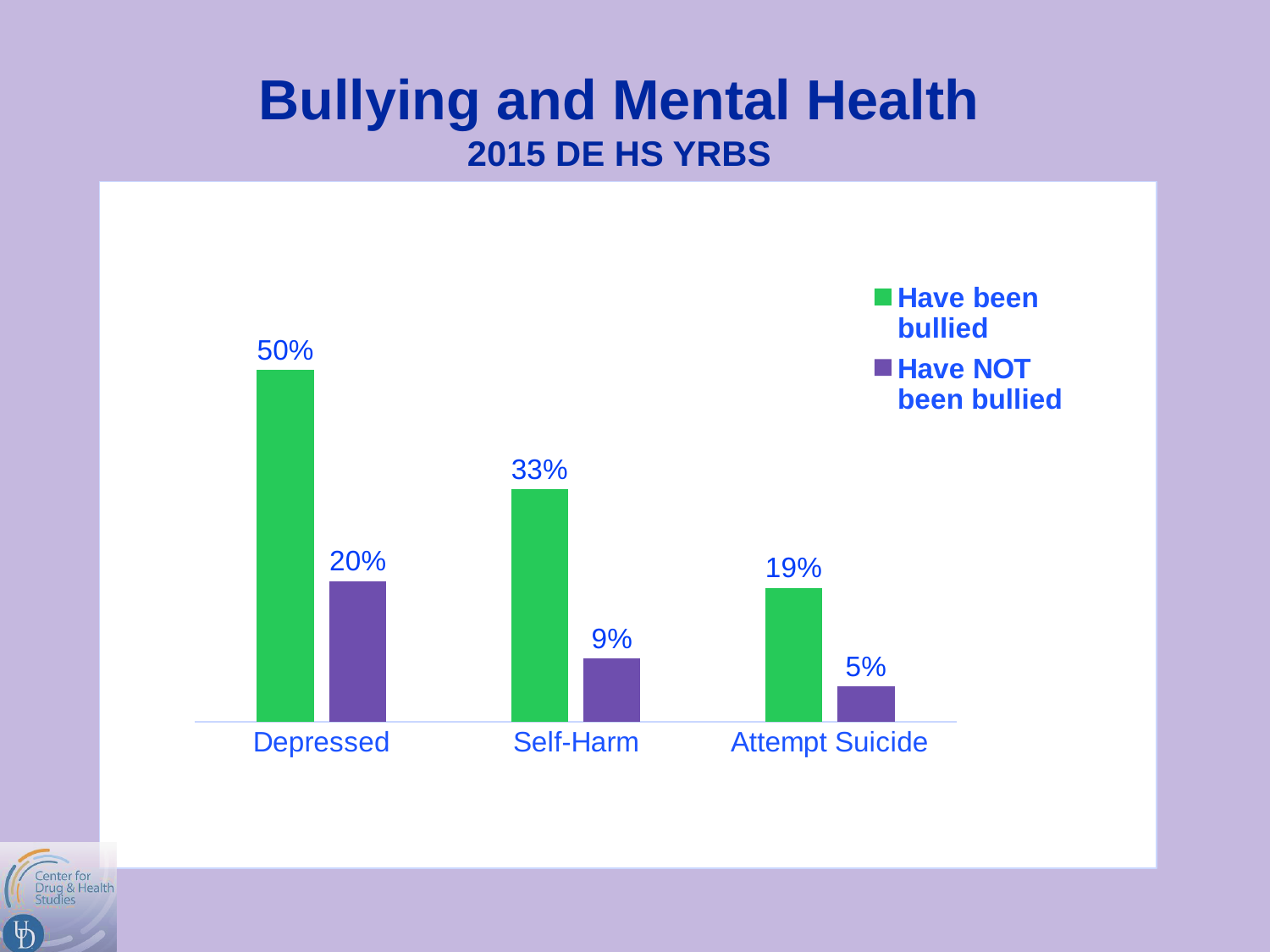
Which category has the lowest value for students who have NOT been bullied? Attempt Suicide How many categories are shown on the x axis? 3 What percentage of students who have been bullied reported being depressed? 50% What is the value for Self-Harm among students who have NOT been bullied? 9% What is the difference between the bullied and not-bullied values for Depressed? 30% How many series does the legend list? 2 What is the difference between the bullied and not-bullied values for Self-Harm? 24% Which colour represents students who have NOT been bullied? Purple What kind of chart is shown on the slide? Bar chart Which is larger: the Self-Harm value for students who have been bullied or the Depressed value for students who have NOT been bullied? Self-Harm for students who have been bullied What percentage of students who have been bullied reported attempting suicide? 19% Which category has the highest value for students who have been bullied? Depressed